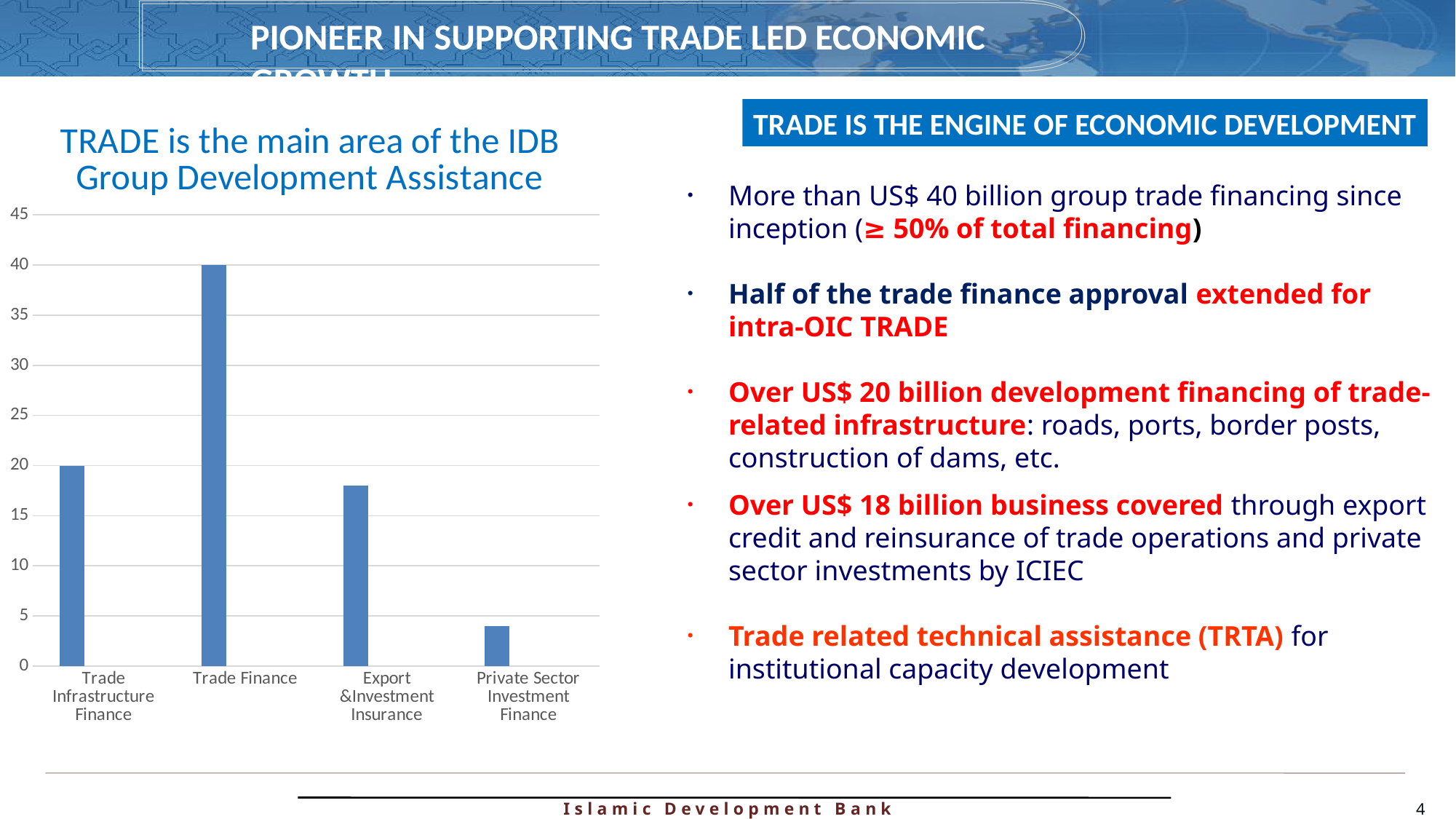
How many categories are shown on the chart's x axis? 4 Which category has the highest bar in the chart? Trade Finance Is the value for Export & Investment Insurance greater or less than 15? greater Is the value for Private Sector Investment Finance greater or less than 5? less What is the value for Trade Finance in the chart? 40 What is the difference between the values for Trade Finance and Trade Infrastructure Finance? 20 What is the value for Trade Infrastructure Finance in the chart? 20 What is the title of the chart? TRADE is the main area of the IDB Group Development Assistance Which is larger, the value for Trade Infrastructure Finance or the value for Export & Investment Insurance? Trade Infrastructure Finance Which category has the lowest bar in the chart? Private Sector Investment Finance Is the value for Export & Investment Insurance greater or less than 20? less What type of chart is shown on the slide? bar chart